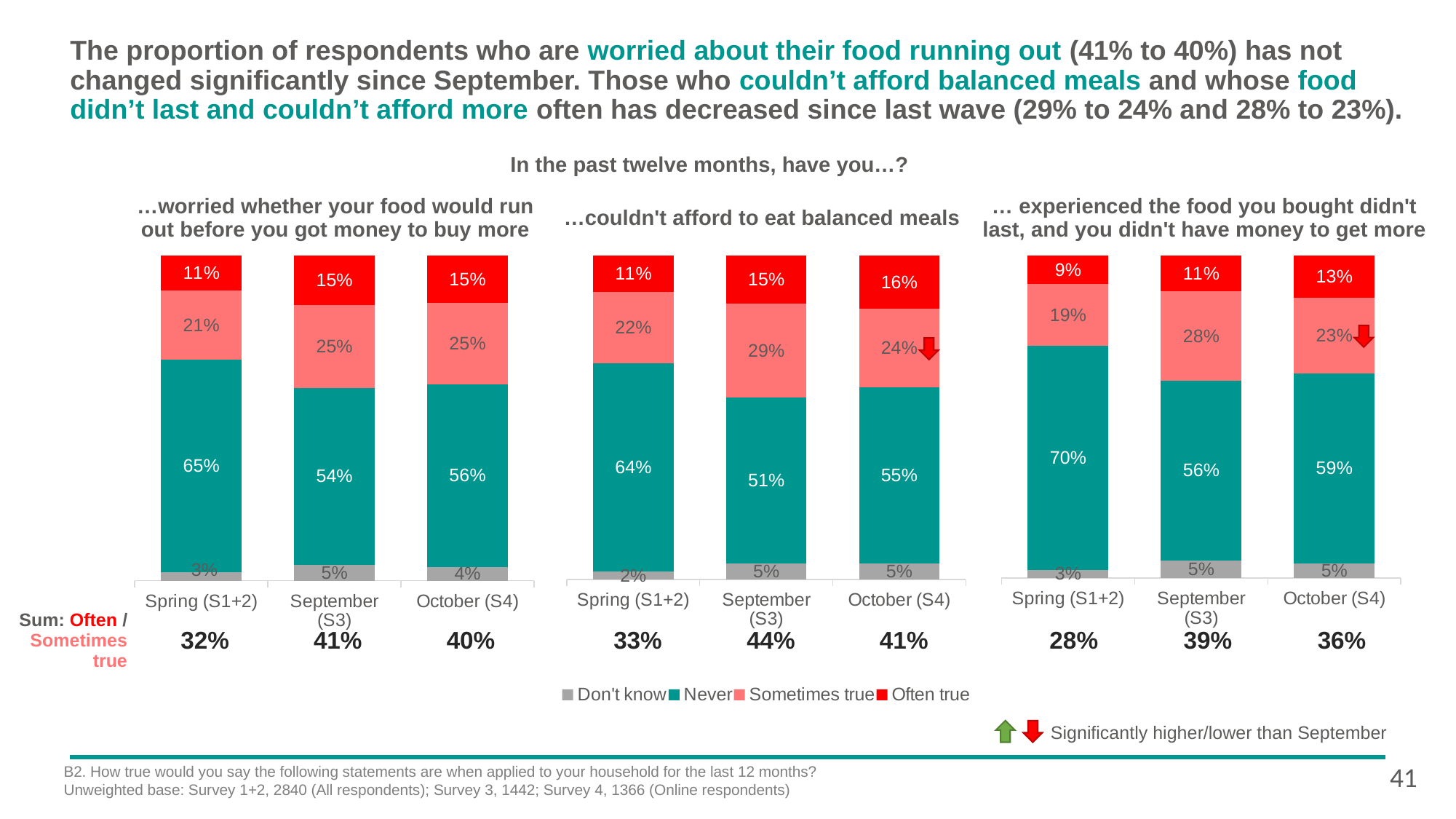
In the chart '… experienced the food you bought didn't last, and you didn't have money to get more', which wave has the highest 'Never' value? Spring (S1+2) In the chart '…worried whether your food would run out before you got money to buy more', what is the sum of 'Often true' and 'Sometimes true' for October (S4)? 40% In the chart '…couldn't afford to eat balanced meals', what is the 'Sometimes true' value for September (S3)? 29% In the chart '…couldn't afford to eat balanced meals', what is the 'Don't know' value for Spring (S1+2)? 2% In the chart '…couldn't afford to eat balanced meals', what is the difference between the 'Never' values for October (S4) and September (S3)? 4% What kind of chart is used for '…couldn't afford to eat balanced meals'? Stacked bar chart In the chart '…worried whether your food would run out before you got money to buy more', what is the 'Never' value for Spring (S1+2)? 65% How many series does the legend list? 4 In the chart '… experienced the food you bought didn't last, and you didn't have money to get more', is the 'Sometimes true' value larger for September (S3) or October (S4)? September (S3) In the chart '…worried whether your food would run out before you got money to buy more', which wave has the lowest 'Often true' value? Spring (S1+2) How many waves (categories) are shown in the chart '…worried whether your food would run out before you got money to buy more'? 3 In the chart '… experienced the food you bought didn't last, and you didn't have money to get more', what is the 'Often true' value for October (S4)? 13%